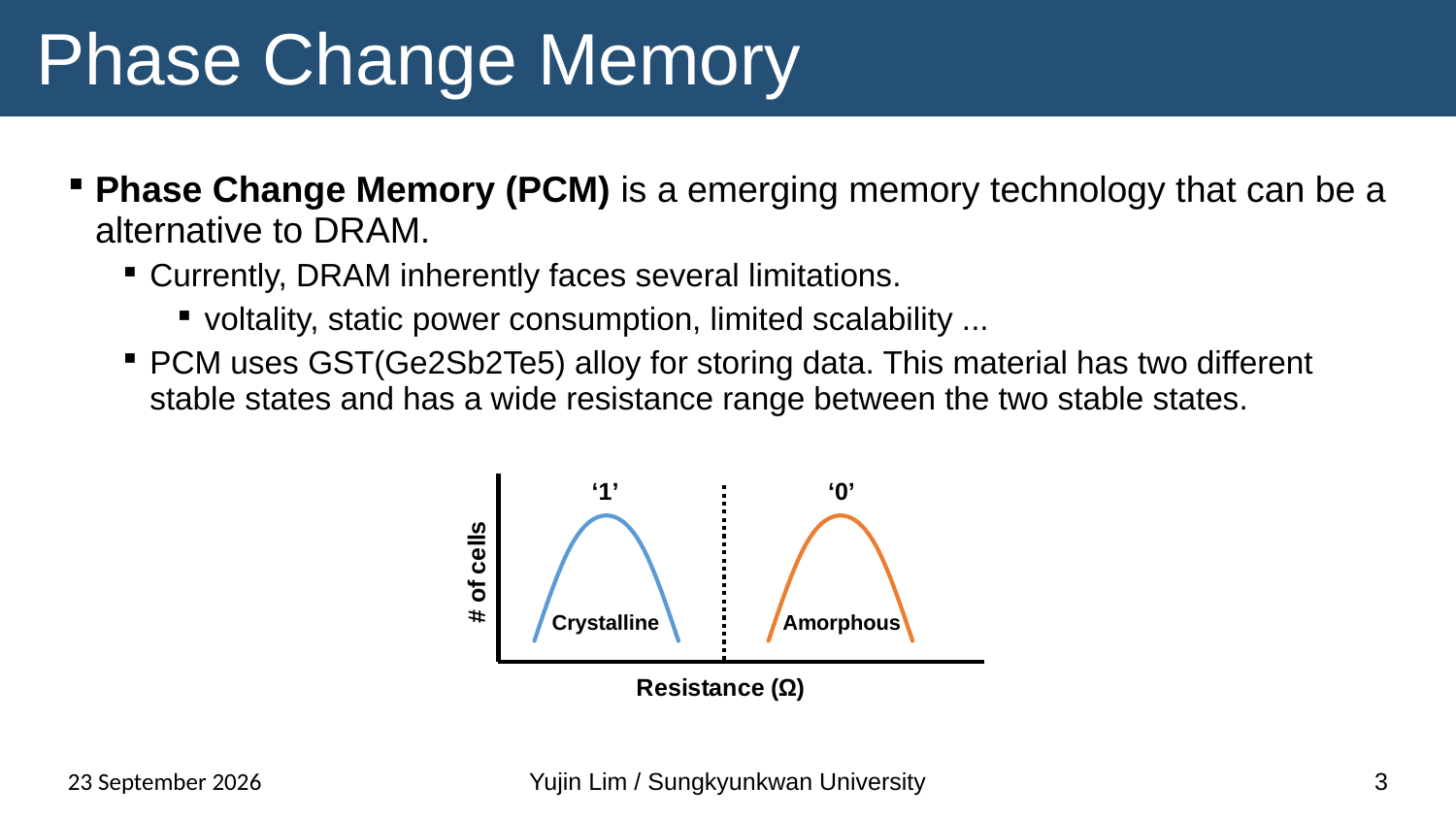
Which state is plotted at the highest resistance on the chart? Amorphous What label is shown on the y axis of the chart? # of cells Which state on the chart is labelled with the bit value '1'? Crystalline How many distribution curves are plotted on the chart? 2 What label is shown on the x axis of the chart? Resistance (Ω) Which curve appears on the left side of the dashed divider, Crystalline or Amorphous? Crystalline What bit value is written above the Crystalline curve? '1' What bit value is written above the Amorphous curve? '0' Which state is plotted at the lowest resistance on the chart? Crystalline Which state is plotted at higher resistance, Crystalline or Amorphous? Amorphous Which state on the chart is labelled with the bit value '0'? Amorphous What kind of chart is shown on the slide? line chart